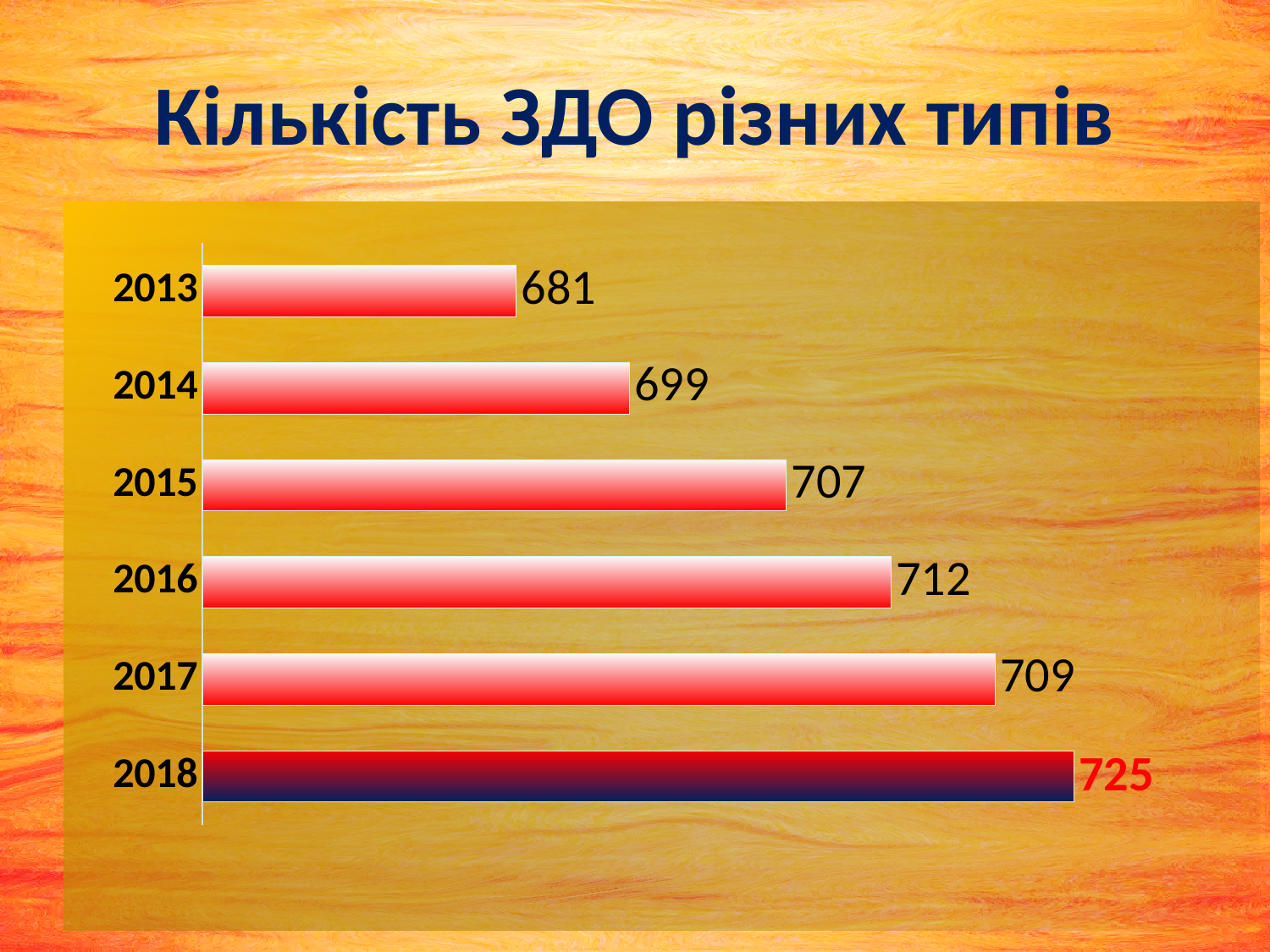
Which year's bar is coloured differently from the others? 2018 What kind of chart is shown on the slide? bar chart How many years are shown in the chart? 6 What is the difference between the values for 2018 and 2013? 44 Which year has the highest value? 2018 What is the title of the chart on the slide? Кількість ЗДО різних типів What is the value for 2013? 681 What is the difference between the values for 2017 and 2016? 3 Which year has the lowest value? 2013 Which is larger, the value for 2014 or the value for 2015? 2015 What is the value for 2018? 725 What is the value for 2016? 712